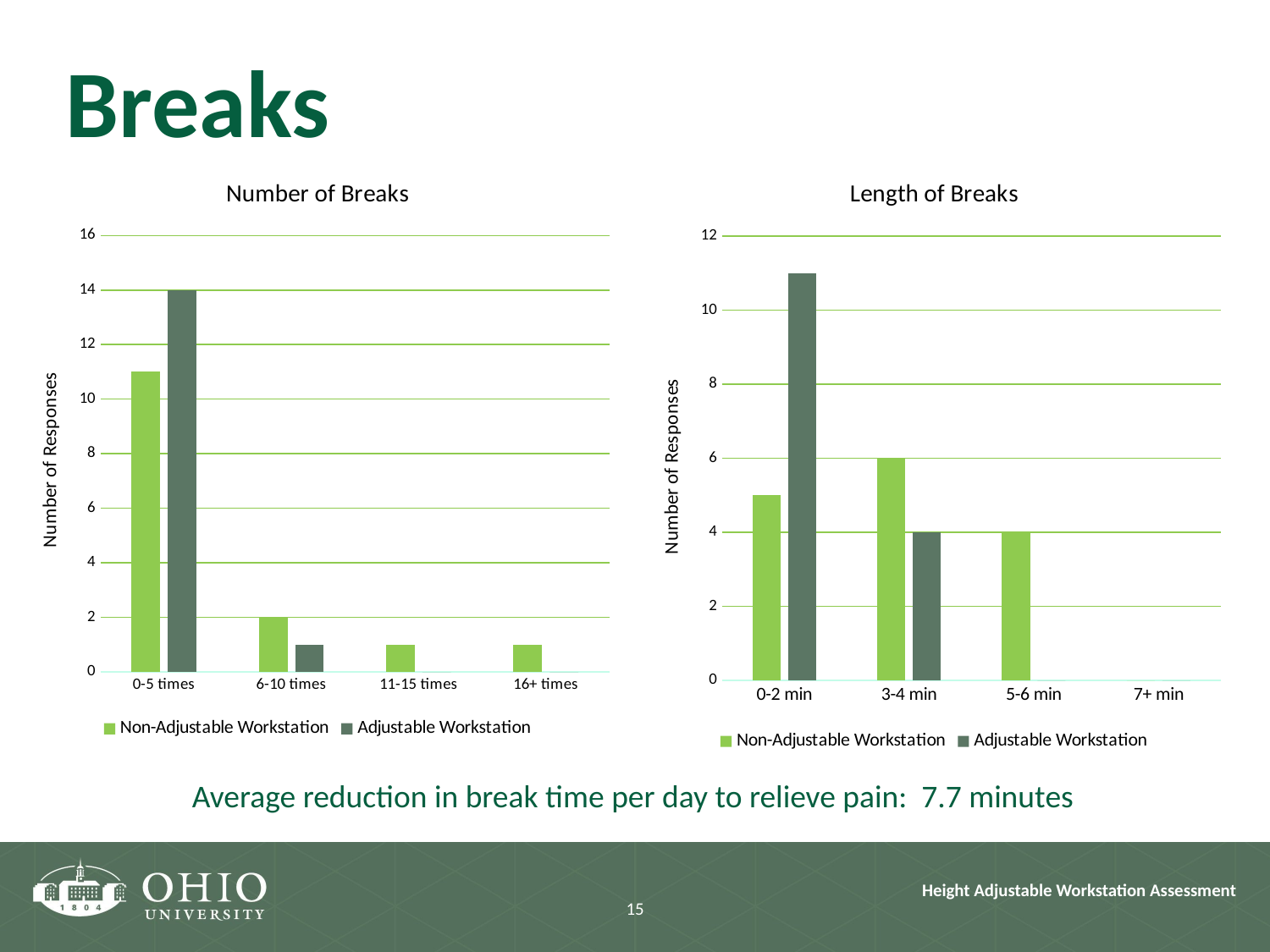
How many categories are shown on the x axis of the Length of Breaks chart? 4 In the Number of Breaks chart, which category has the highest value for Adjustable Workstation? 0-5 times In the Length of Breaks chart, what is the value for Adjustable Workstation at 3-4 min? 4 In the Length of Breaks chart, what is the value for Non-Adjustable Workstation at 3-4 min? 6 In the Number of Breaks chart, what is the value for Adjustable Workstation at 0-5 times? 14 In the Length of Breaks chart, is the value for Adjustable Workstation at 0-2 min greater or less than 10? greater In the Length of Breaks chart, what is the difference between Non-Adjustable Workstation and Adjustable Workstation at 3-4 min? 2 How many series does the legend of the Number of Breaks chart list? 2 What type of chart is the Length of Breaks chart? bar chart In the Number of Breaks chart, at 0-5 times, which series has the larger value: Non-Adjustable Workstation or Adjustable Workstation? Adjustable Workstation In the Number of Breaks chart, what is the value for Non-Adjustable Workstation at 6-10 times? 2 In the Number of Breaks chart, is the value for Non-Adjustable Workstation at 0-5 times greater or less than 10? greater